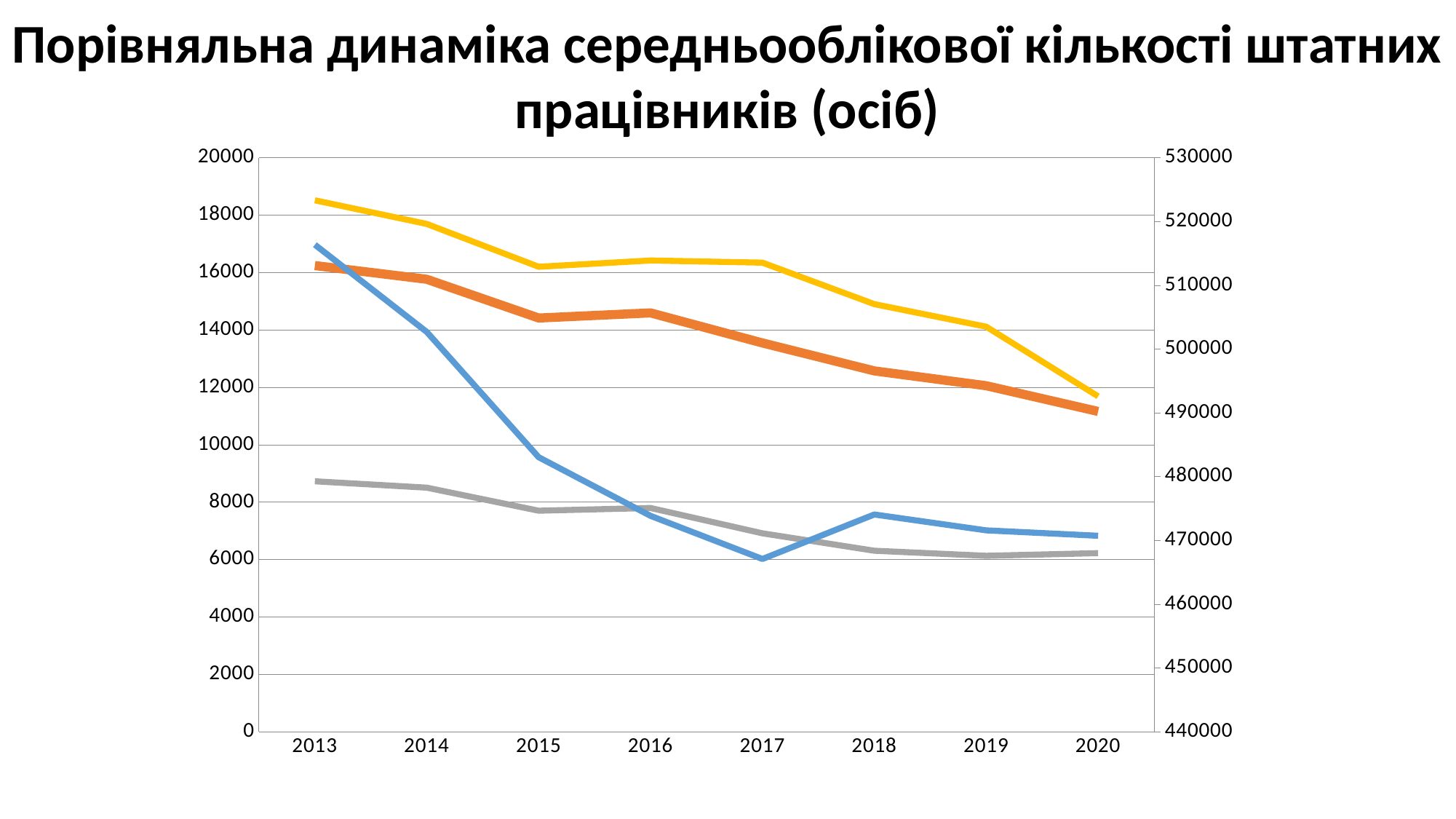
Does the yellow line rise or fall overall from 2013 to 2020? fall Does the orange line rise or fall overall from 2013 to 2020? fall What kind of chart is shown on the slide? line chart Does the gray line rise or fall overall from 2013 to 2020? fall What is the last year shown on the x axis? 2020 How many years are shown along the x axis of the chart? 8 In which year does the blue line reach its highest point? 2013 What is the first year shown on the x axis? 2013 Which line is plotted highest on the chart in 2013? the yellow line How many lines are plotted on the chart? 4 In which year does the blue line reach its lowest point? 2017